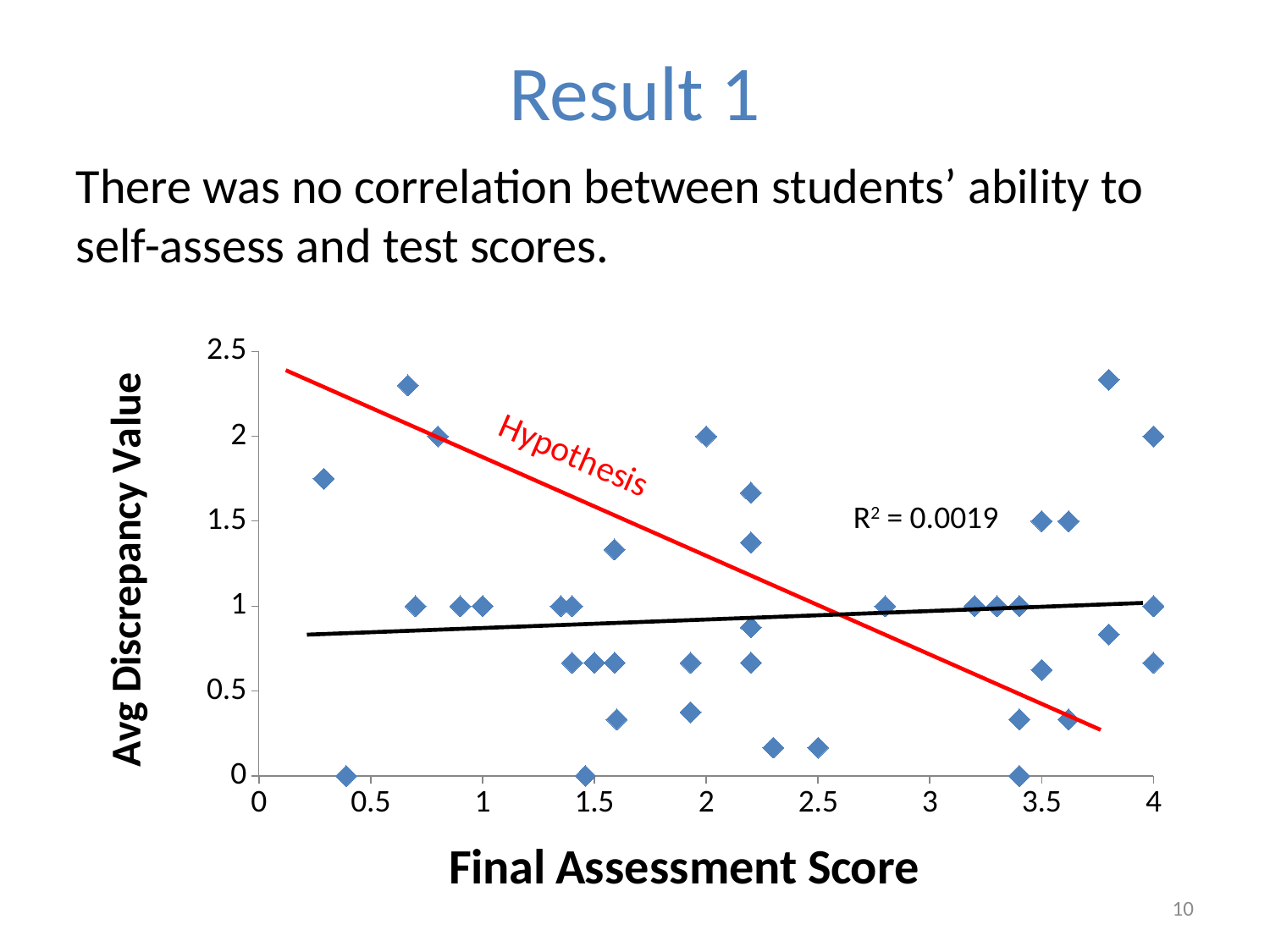
Is the Avg Discrepancy Value of the point at Final Assessment Score 2.5 greater or less than 0.5? less What is the R² value printed on the chart? 0.0019 Does the black trendline rise or fall as Final Assessment Score increases? rise What is the highest value shown on the x axis? 4 What label is written along the red line? Hypothesis Does the red Hypothesis line rise or fall as Final Assessment Score increases? fall What kind of chart is shown on the slide? scatter chart What is the lowest Avg Discrepancy Value plotted on the chart? 0 What is the title of the y axis? Avg Discrepancy Value What is the title of the x axis? Final Assessment Score What is the highest value shown on the y axis? 2.5 Is the highest plotted Avg Discrepancy Value greater or less than 2? greater